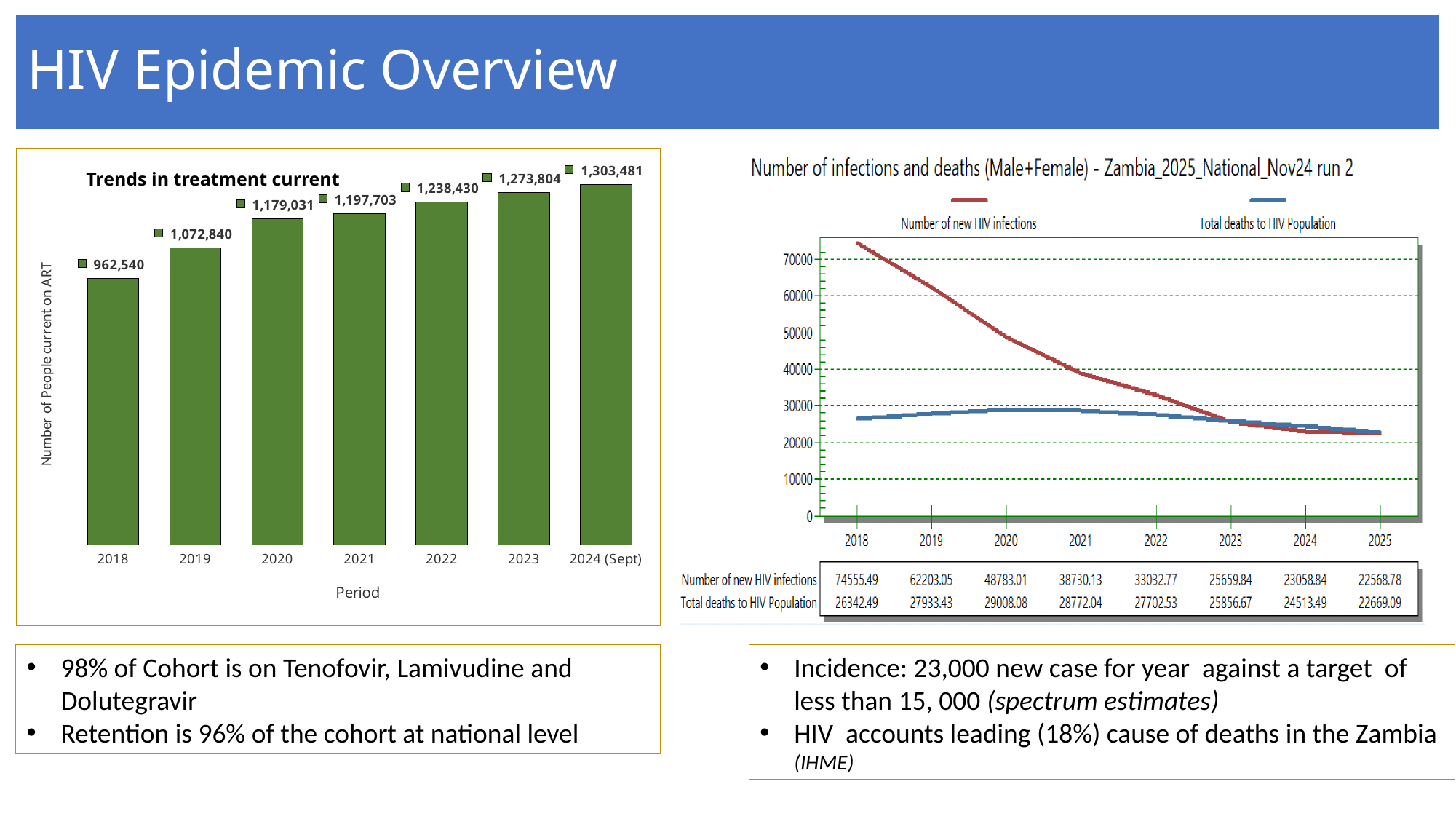
What kind of chart is the 'Trends in treatment current' chart? bar chart In the 'Trends in treatment current' chart, what is the value for 2024 (Sept)? 1,303,481 In the 'Number of infections and deaths' chart, which year has the highest total deaths to HIV population? 2020 In the 'Number of infections and deaths' chart, what is the number of new HIV infections in 2018? 74555.49 In the 'Trends in treatment current' chart, what is the difference between the 2019 and 2018 values? 110,300 In the 'Trends in treatment current' chart, which period has the highest number of people current on ART? 2024 (Sept) In the 'Trends in treatment current' chart, do the values rise or fall from 2018 to 2024 (Sept)? rise How many series does the legend of the 'Number of infections and deaths' chart list? 2 In the 'Trends in treatment current' chart, how many periods are shown on the x axis? 7 In the 'Number of infections and deaths' chart, which is larger in 2021: number of new HIV infections or total deaths to HIV population? Number of new HIV infections In the 'Trends in treatment current' chart, what is the number of people current on ART in 2018? 962,540 In the 'Number of infections and deaths' chart, what is the total deaths to HIV population in 2020? 29008.08